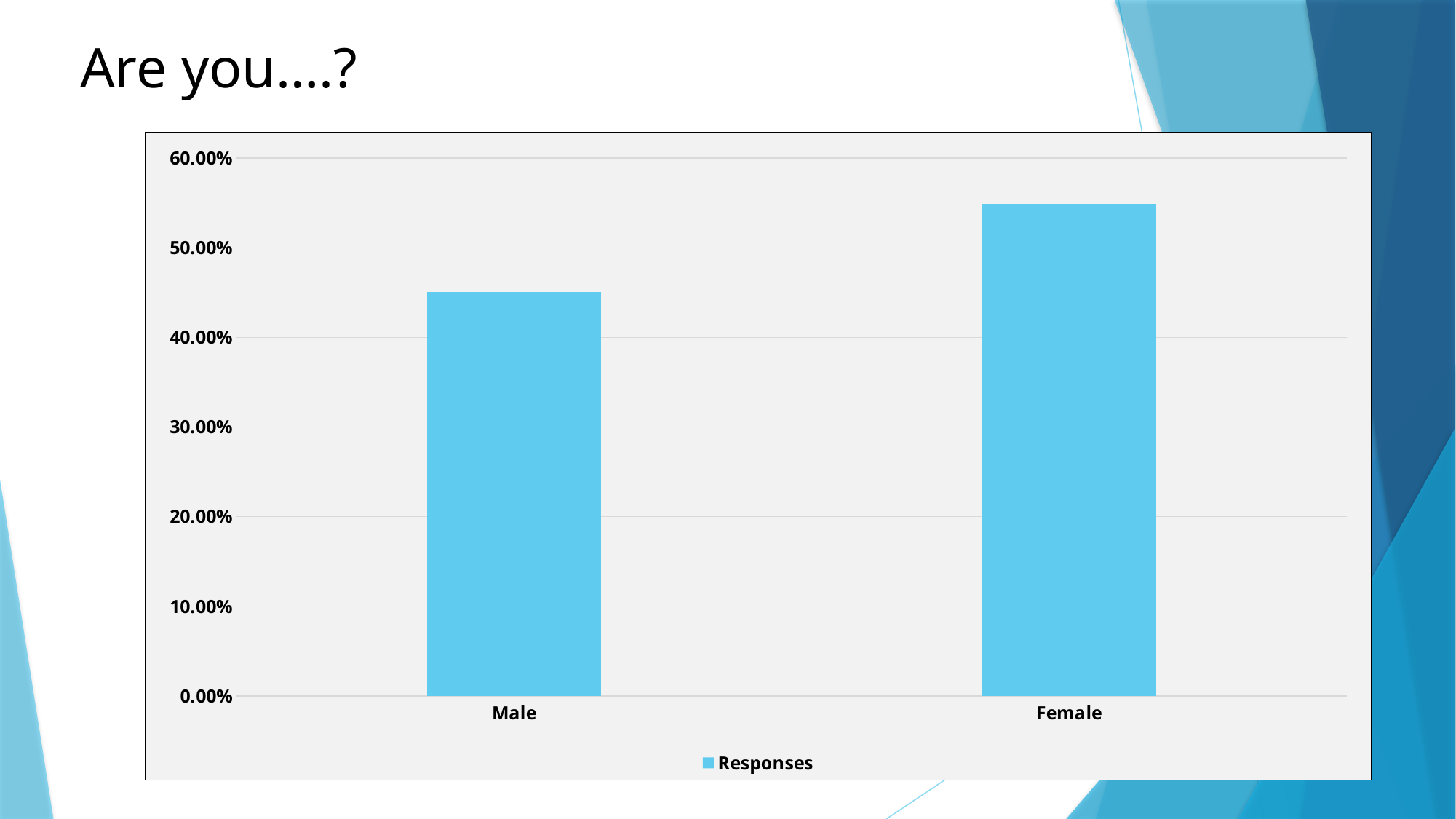
Is the value for Male greater or less than 40.00%? greater How many categories are shown on the x axis of the chart? 2 What is the name of the series listed in the chart's legend? Responses Is the value for Male greater or less than 50.00%? less Which is larger, the value for Male or the value for Female? Female How many series does the chart's legend list? 1 Which category has the highest value in the chart? Female Which category has the lowest value in the chart? Male Is the value for Female greater or less than 60.00%? less What is the title of the slide containing the chart? Are you....? What kind of chart is shown on the slide? bar chart